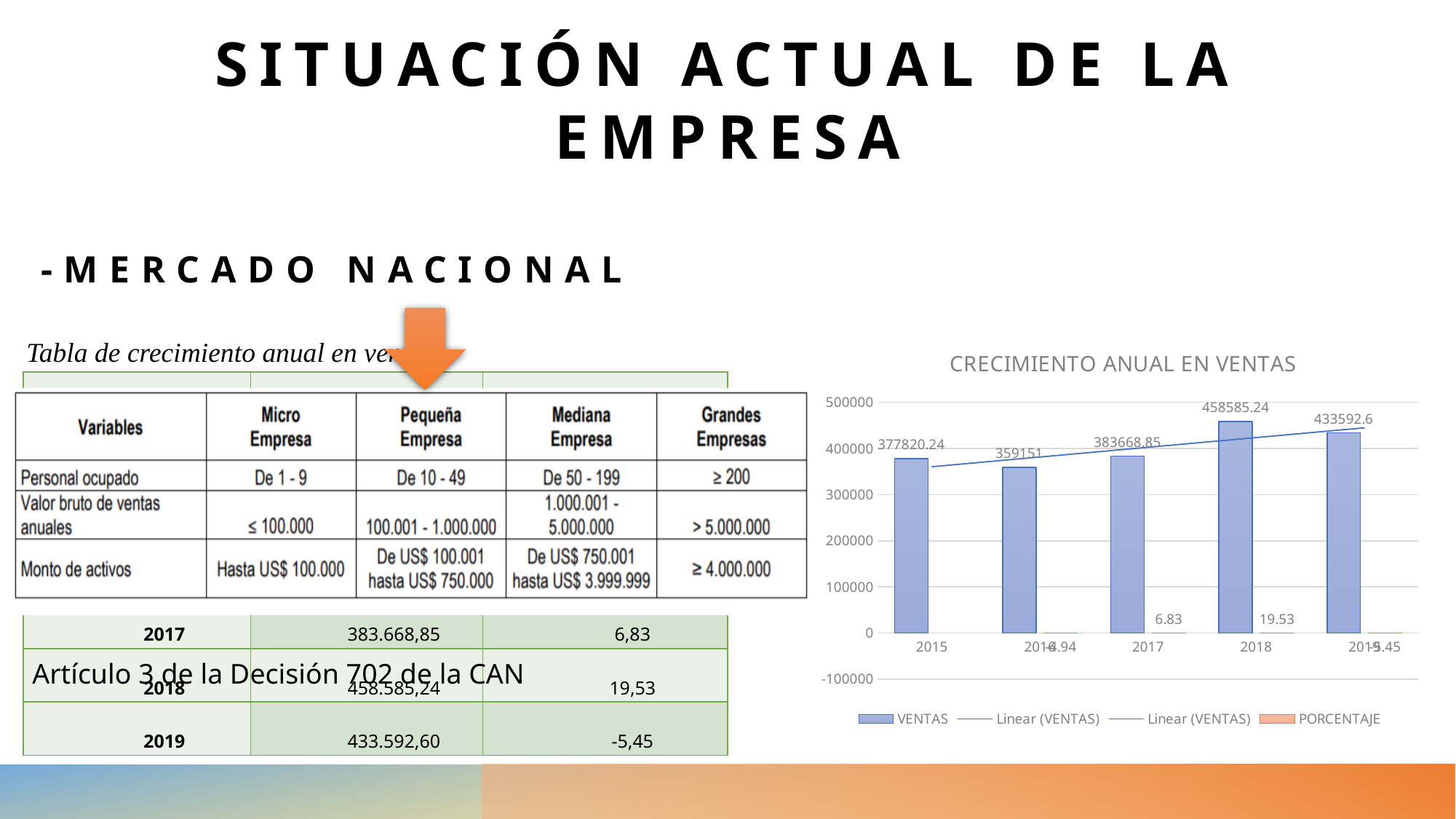
What is the PORCENTAJE value shown for 2017 in the chart? 6.83 Which is larger in the chart, the VENTAS value for 2015 or for 2017? 2017 Which year has the lowest VENTAS value in the chart? 2016 How many years are shown on the x axis of the chart? 5 What is the difference between the VENTAS values for 2018 and 2019 in the chart? 24992.64 What kind of chart is used to show VENTAS in the chart? bar chart What is the title of the chart on the slide? CRECIMIENTO ANUAL EN VENTAS What is the VENTAS value for 2015 in the chart? 377820.24 What is the VENTAS value for 2019 in the chart? 433592.6 Which year has the highest VENTAS value in the chart? 2018 What is the VENTAS value for 2018 in the chart? 458585.24 How many entries does the legend of the chart list? 4